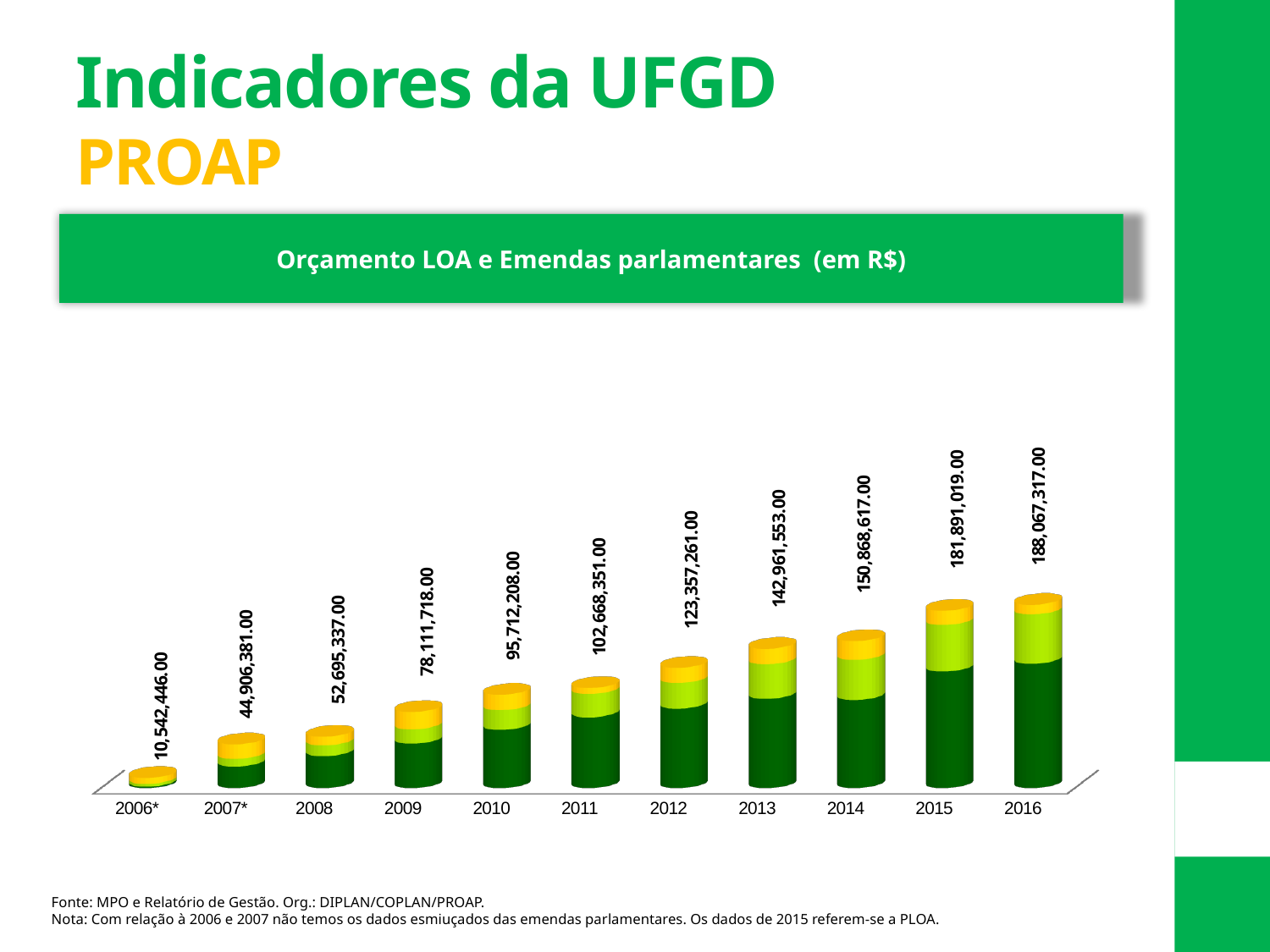
What is the total value shown for 2010? 95,712,208.00 How many years are shown on the x axis? 11 What is the total value shown for 2016? 188,067,317.00 What is the total value shown for 2013? 142,961,553.00 What kind of chart is shown on the slide? Bar chart What is the difference between the total values for 2007* and 2006*? 34,363,935.00 Which year has the lowest total value? 2006* What is the total value shown for 2006*? 10,542,446.00 Which is larger, the total value for 2011 or for 2012? 2012 Which year has the highest total value? 2016 What is the difference between the total values for 2016 and 2015? 6,176,298.00 Do the total values rise or fall from 2006* to 2016? Rise